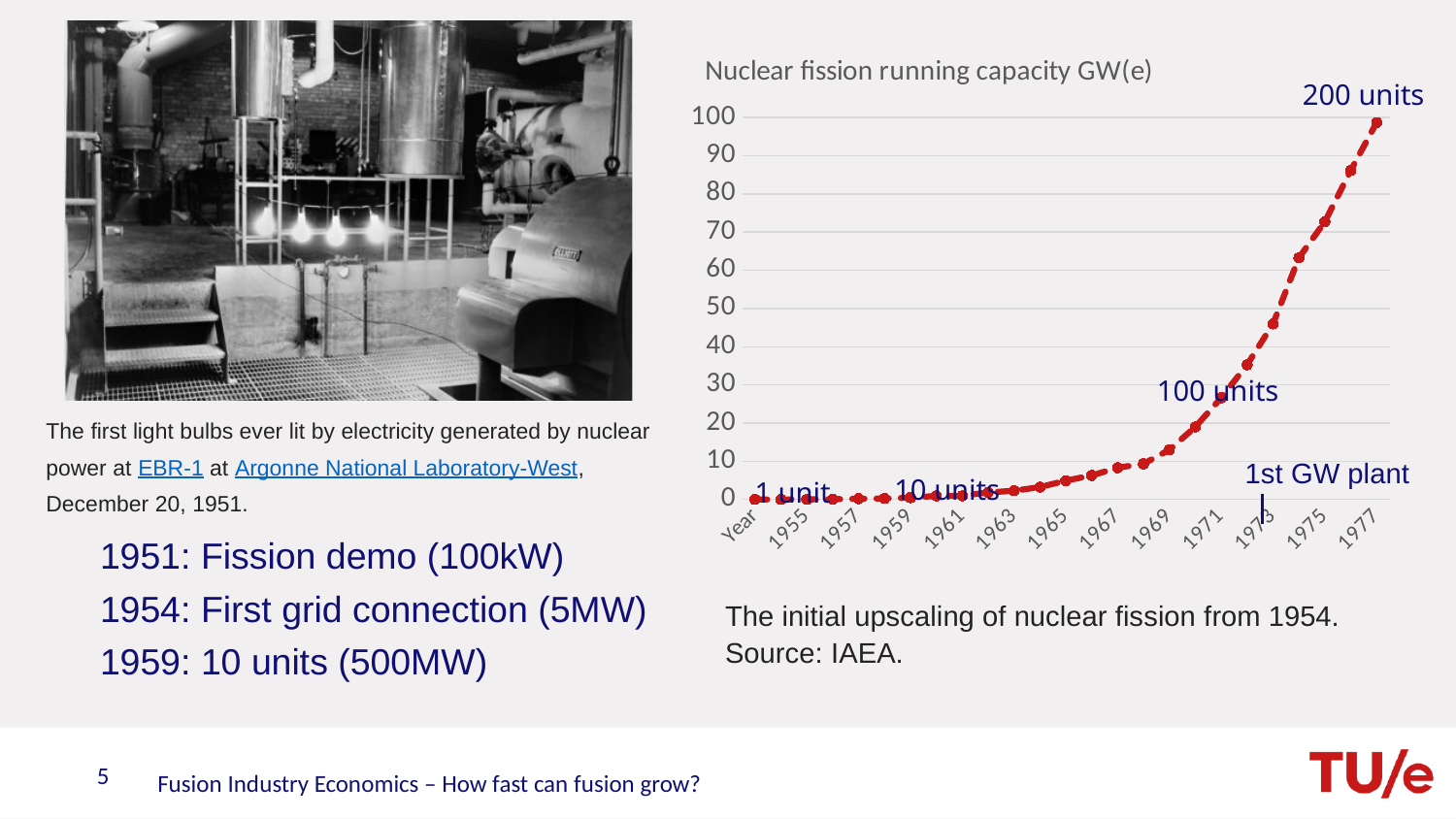
What is the title of the chart? Nuclear fission running capacity GW(e) Which year has the larger running capacity, 1969 or 1975? 1975 What annotation is placed at the top right end of the line? 200 units Is the running capacity in 1971 greater or less than 20? greater What kind of chart is shown on the slide? line chart Is the running capacity in 1975 greater or less than 60? greater Which year has the highest nuclear fission running capacity on the chart? 1977 Is the running capacity in 1965 greater or less than 10? less What is the highest tick value shown on the y axis? 100 Does the nuclear fission running capacity rise or fall over the years shown? rise